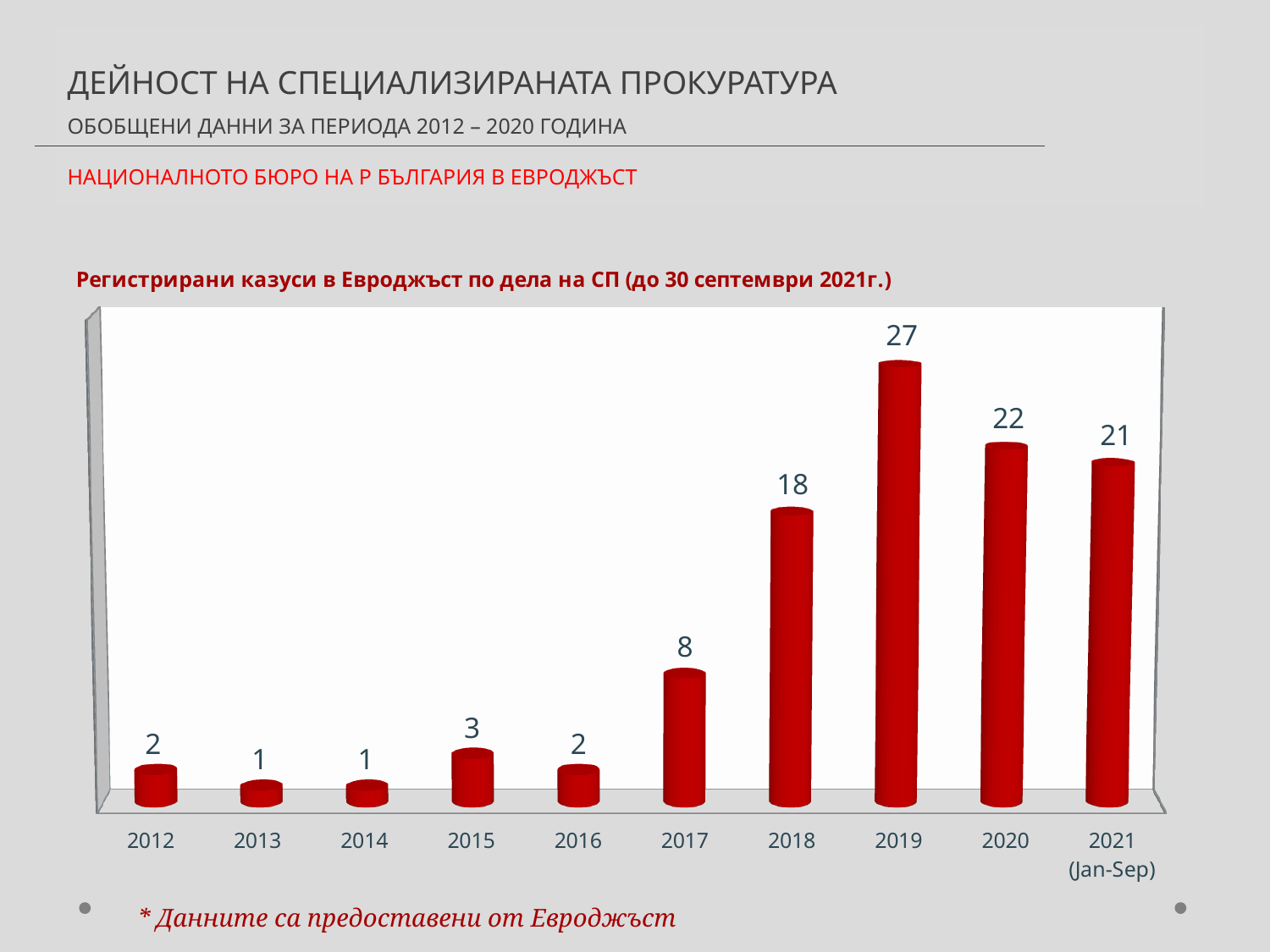
What is the value for 2017? 8 What is the value for 2021 (Jan-Sep)? 21 What is the title of the chart? Регистрирани казуси в Евроджъст по дела на СП (до 30 септември 2021г.) Do the values generally rise or fall from 2014 to 2019? rise Which year has the highest value? 2019 How many years (categories) are shown on the x axis? 10 What is the value for 2019? 27 What kind of chart is shown on the slide? bar chart Which is larger, the value for 2020 or the value for 2021 (Jan-Sep)? 2020 What is the difference between the values for 2019 and 2020? 5 What colour are the bars in the chart? red What is the difference between the values for 2018 and 2017? 10